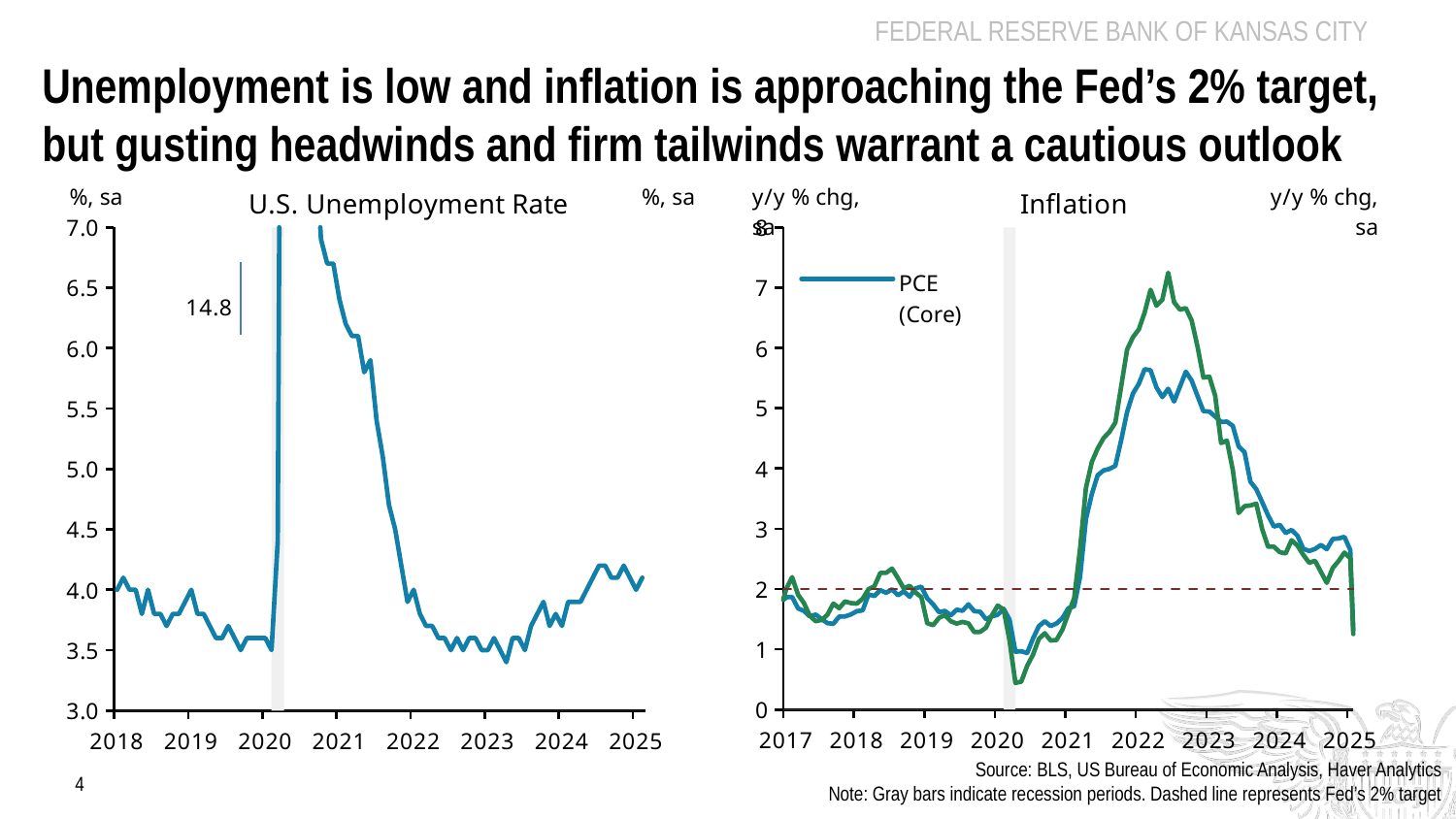
On the U.S. Unemployment Rate chart, does the unemployment rate rise or fall between 2021 and 2022? fall On the U.S. Unemployment Rate chart, is the unemployment rate at the start of 2021 greater or less than 6.0? greater On the Inflation chart, what does the dashed line represent? Fed's 2% target On the Inflation chart, does the PCE (Core) line rise or fall between 2022 and 2024? fall On the U.S. Unemployment Rate chart, in which year does the unemployment rate reach its highest point? 2020 On the Inflation chart, is the PCE (Core) value at the start of 2022 greater or less than 5? greater On the U.S. Unemployment Rate chart, is the unemployment rate at the start of 2023 greater or less than 4.0? less What kind of chart is the U.S. Unemployment Rate chart? line chart On the Inflation chart, which line reaches a higher peak in 2022, the green line or the PCE (Core) line? the green line How many year labels are shown on the x axis of the U.S. Unemployment Rate chart? 8 How many series does the legend of the Inflation chart list? 1 On the U.S. Unemployment Rate chart, what peak value is labeled in 2020? 14.8